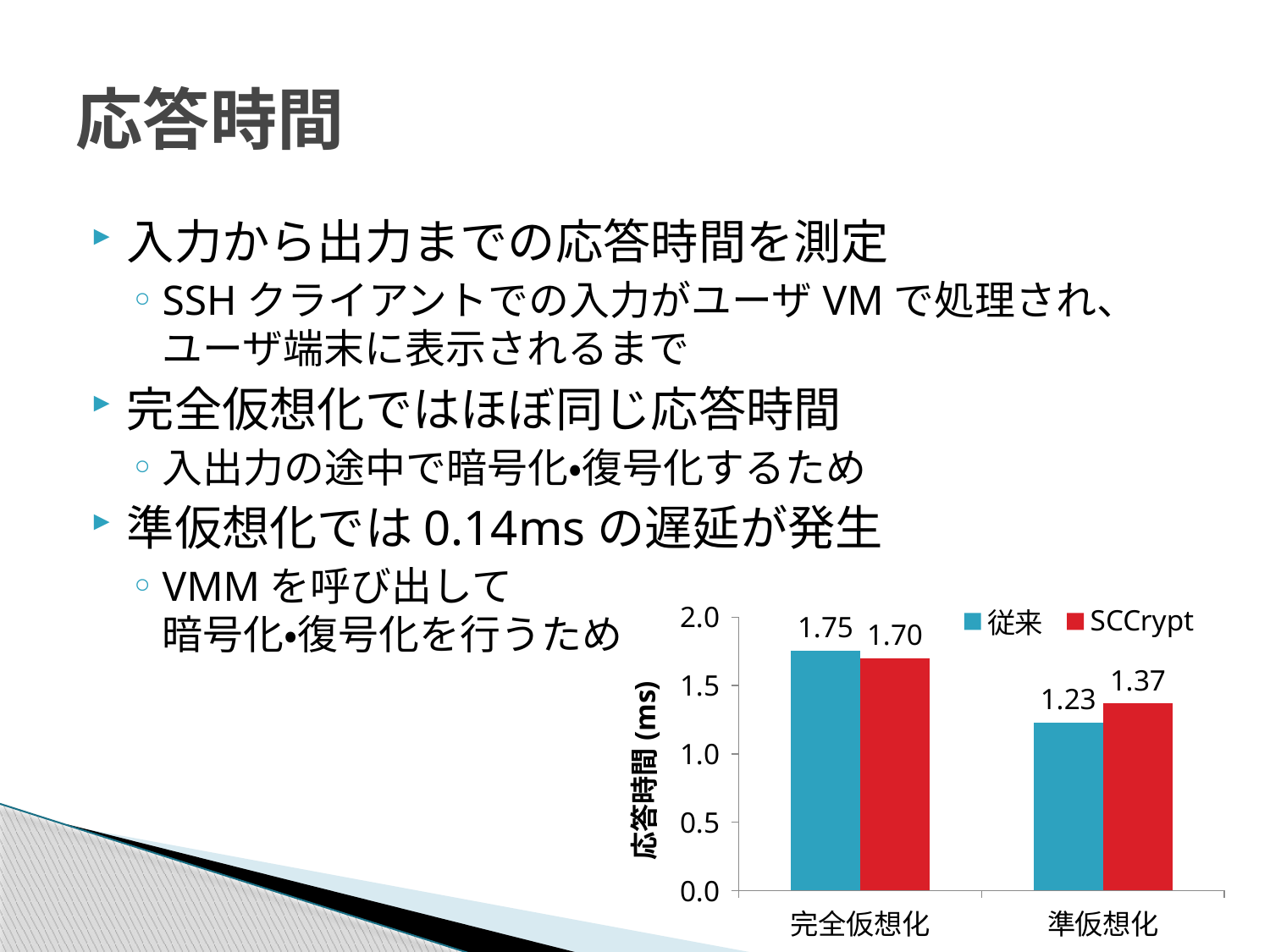
What is the label of the y axis? 応答時間 (ms) Which series has the highest value in the 完全仮想化 category? 従来 Which is larger: 従来 in 完全仮想化 or 従来 in 準仮想化? 従来 in 完全仮想化 What kind of chart is shown on the slide? bar chart What is the value for 従来 in the 完全仮想化 category? 1.75 What is the value for 従来 in the 準仮想化 category? 1.23 Which series has the lowest value in the 準仮想化 category? 従来 What is the value for SCCrypt in the 準仮想化 category? 1.37 What is the value for SCCrypt in the 完全仮想化 category? 1.70 How many categories are shown on the x axis? 2 How many series does the legend list? 2 What is the difference between SCCrypt and 従来 in the 準仮想化 category? 0.14